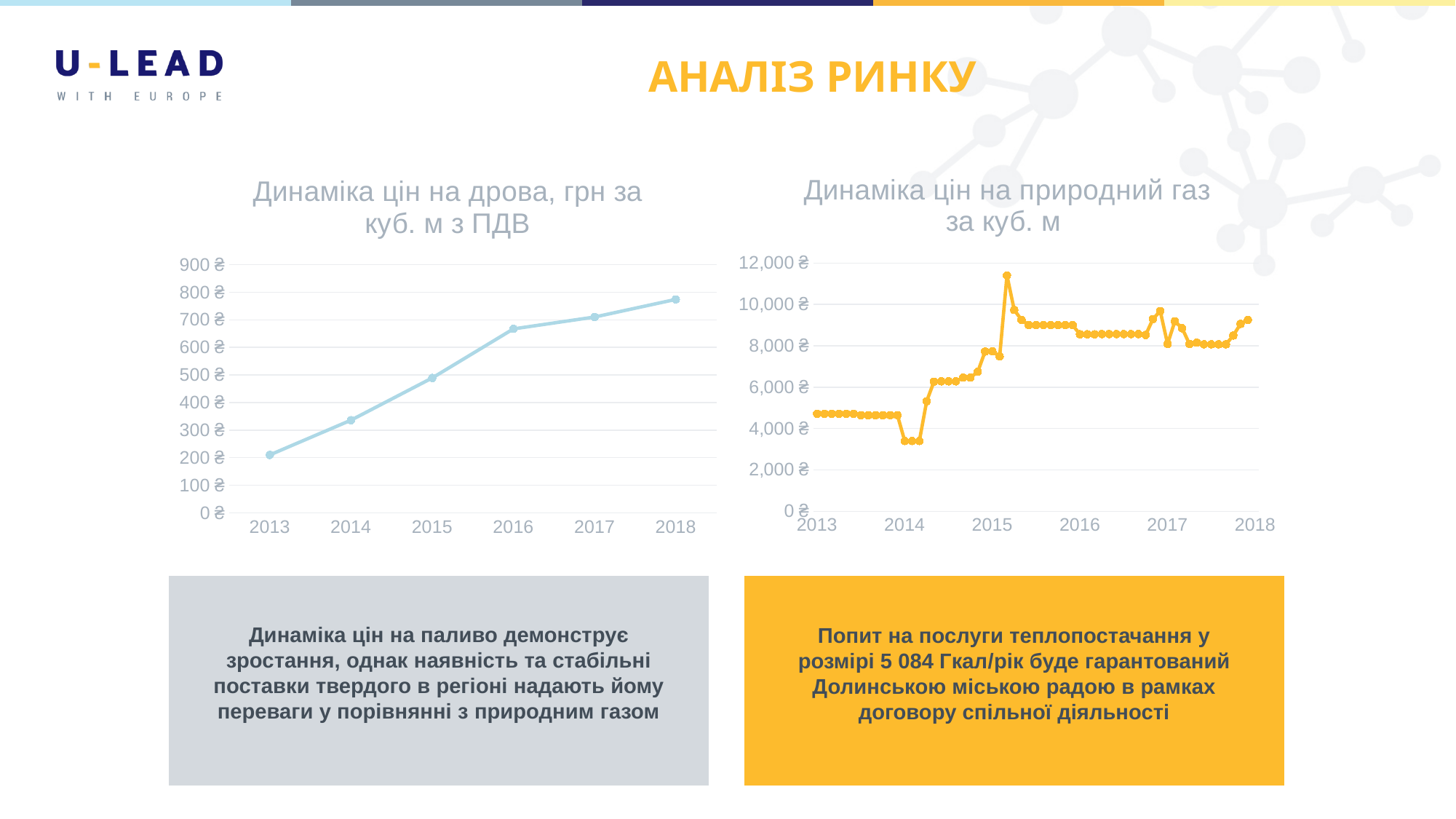
In the left chart (firewood prices), which is larger, the value for 2014 or the value for 2016? 2016 What kind of chart is the right chart titled "Динаміка цін на природний газ за куб. м"? line chart In the left chart (firewood prices), do the values rise or fall from 2013 to 2018? rise In the left chart (firewood prices), is the value for 2015 greater or less than 600 ₴? less In the left chart (firewood prices), which year has the lowest value? 2013 In the left chart (firewood prices), is the value for 2018 greater or less than 700 ₴? greater In the left chart (firewood prices), is the value for 2013 greater or less than 300 ₴? less In the left chart (firewood prices), which year has the highest value? 2018 What kind of chart is the left chart titled "Динаміка цін на дрова, грн за куб. м з ПДВ"? line chart In the left chart (firewood prices), how many years are shown on the x axis? 6